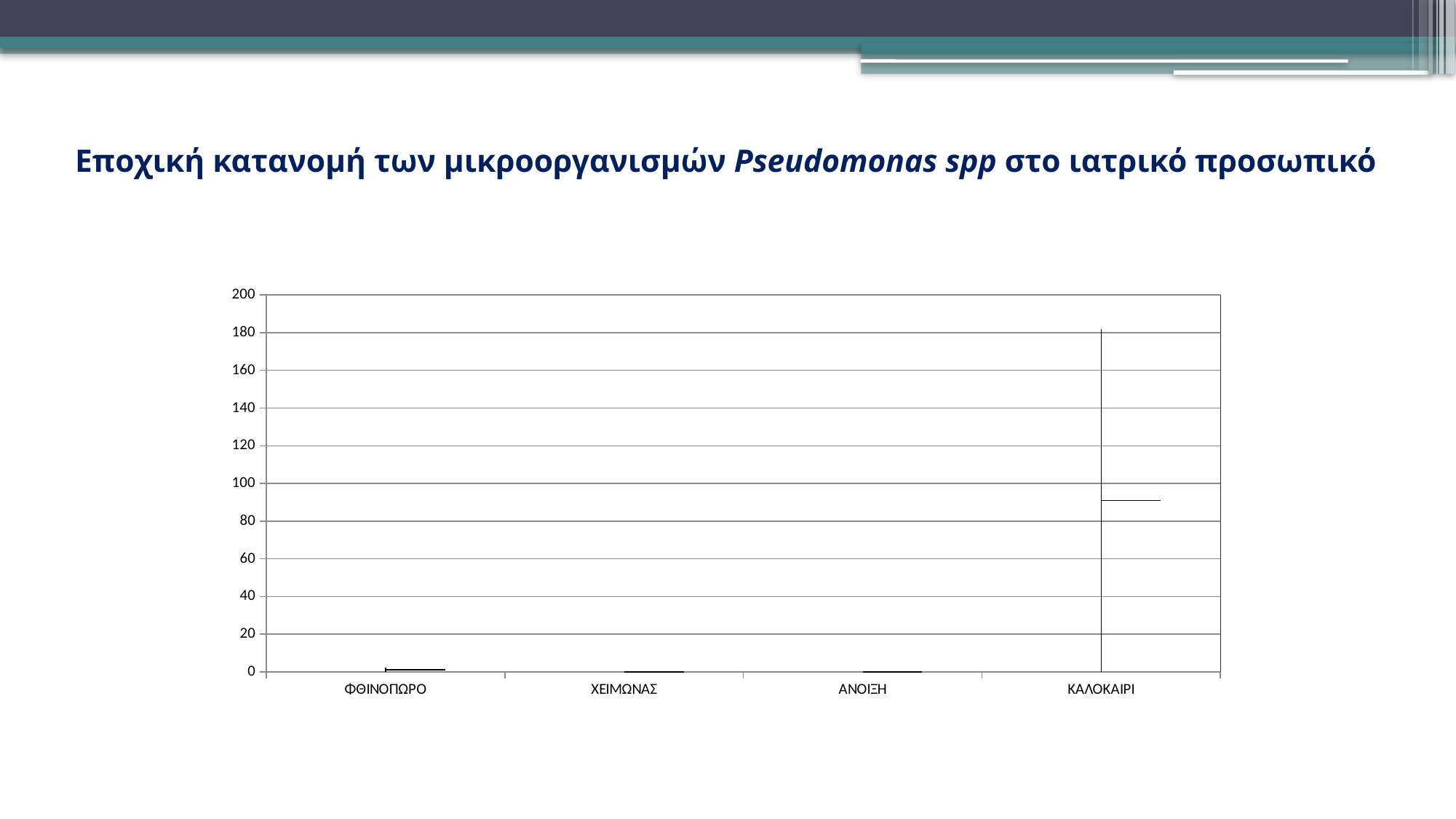
Which is larger, the value for ΚΑΛΟΚΑΙΡΙ or the value for ΧΕΙΜΩΝΑΣ? ΚΑΛΟΚΑΙΡΙ Which is larger, the value for ΚΑΛΟΚΑΙΡΙ or the value for ΑΝΟΙΞΗ? ΚΑΛΟΚΑΙΡΙ What is the title of the slide containing the chart? Εποχική κατανομή των μικροοργανισμών Pseudomonas spp στο ιατρικό προσωπικό What is the maximum value shown on the y axis of the chart? 200 How many categories are shown on the x axis of the chart? 4 What kind of chart is shown on the slide? stock chart (high-low-close chart) Is the value for ΧΕΙΜΩΝΑΣ greater or less than 40? less Which category has the highest value in the chart? ΚΑΛΟΚΑΙΡΙ Is the value for ΦΘΙΝΟΠΩΡΟ greater or less than 20? less Is the value for ΑΝΟΙΞΗ greater or less than 20? less